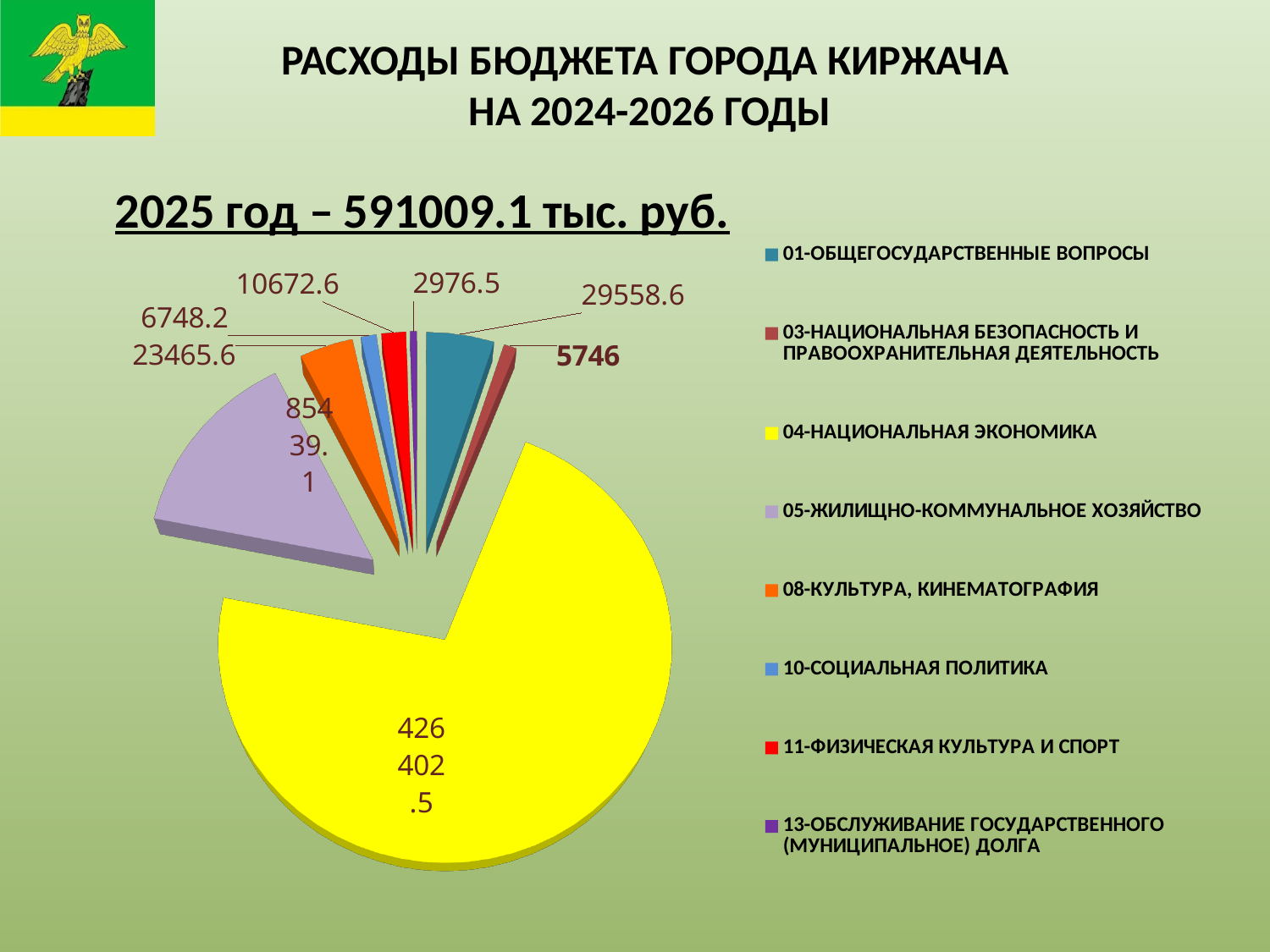
Which category has the largest slice of the pie? 04-НАЦИОНАЛЬНАЯ ЭКОНОМИКА What is the difference between the values for 01-ОБЩЕГОСУДАРСТВЕННЫЕ ВОПРОСЫ and 08-КУЛЬТУРА, КИНЕМАТОГРАФИЯ? 6093 What type of chart is shown on the slide? pie chart What is the value for 05-ЖИЛИЩНО-КОММУНАЛЬНОЕ ХОЗЯЙСТВО? 85439.1 Which is larger: the value for 11-ФИЗИЧЕСКАЯ КУЛЬТУРА И СПОРТ or the value for 10-СОЦИАЛЬНАЯ ПОЛИТИКА? 11-ФИЗИЧЕСКАЯ КУЛЬТУРА И СПОРТ Which category has the smallest slice of the pie? 13-ОБСЛУЖИВАНИЕ ГОСУДАРСТВЕННОГО (МУНИЦИПАЛЬНОЕ) ДОЛГА How many categories does the legend list? 8 What colour is the slice for 08-КУЛЬТУРА, КИНЕМАТОГРАФИЯ? orange What is the value for 04-НАЦИОНАЛЬНАЯ ЭКОНОМИКА? 426402.5 What is the value for 03-НАЦИОНАЛЬНАЯ БЕЗОПАСНОСТЬ И ПРАВООХРАНИТЕЛЬНАЯ ДЕЯТЕЛЬНОСТЬ? 5746 What is the value for 13-ОБСЛУЖИВАНИЕ ГОСУДАРСТВЕННОГО (МУНИЦИПАЛЬНОЕ) ДОЛГА? 2976.5 What is the value for 01-ОБЩЕГОСУДАРСТВЕННЫЕ ВОПРОСЫ? 29558.6